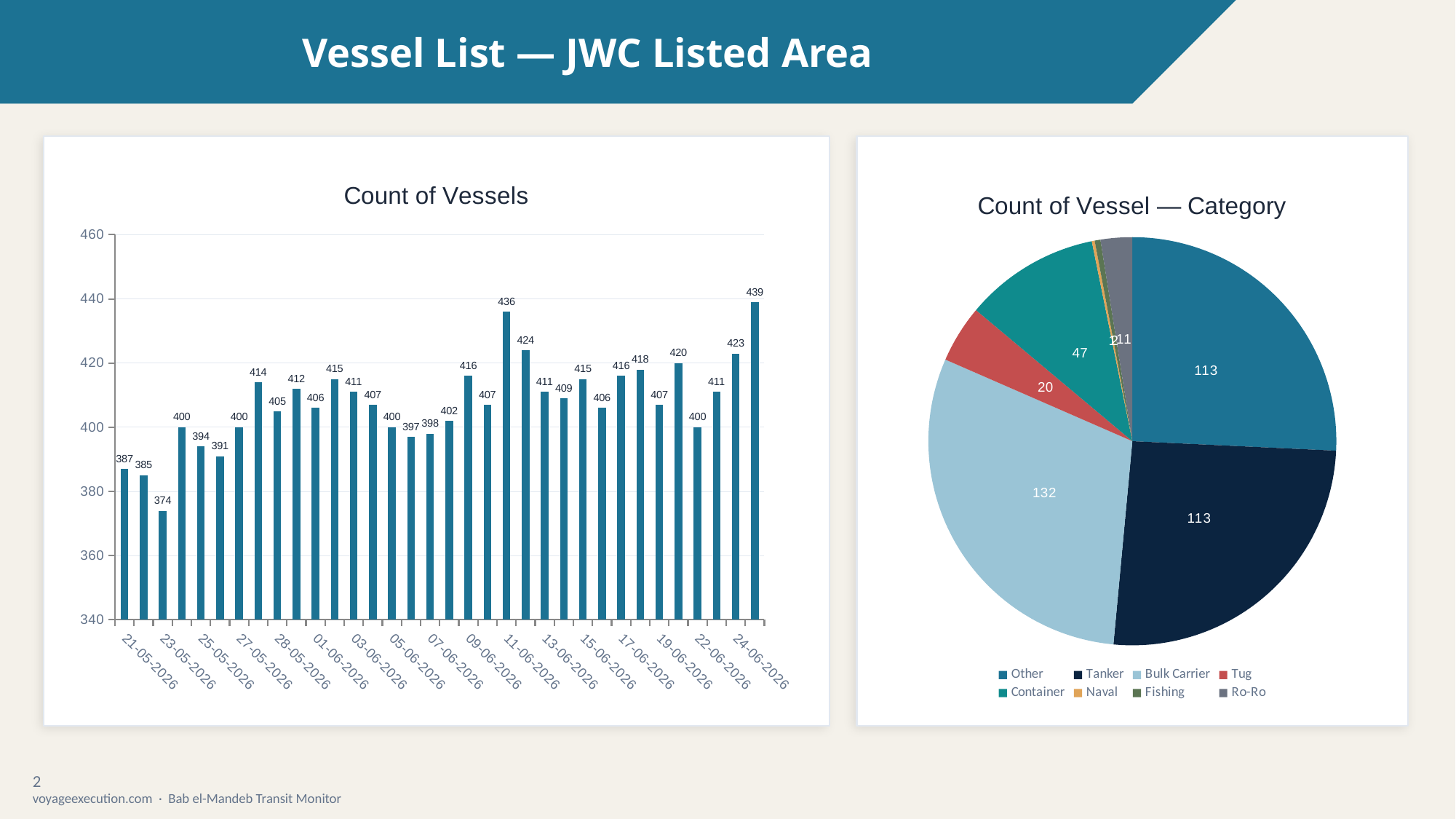
In the 'Count of Vessels' chart, is the value for 21-05-2026 greater or less than 400? less In the 'Count of Vessel — Category' pie chart, what is the value for Container? 47 In the 'Count of Vessels' chart, what is the lowest value shown? 374 How many categories does the legend of the 'Count of Vessel — Category' pie chart list? 8 In the 'Count of Vessels' chart, what is the value for 21-05-2026? 387 In the 'Count of Vessel — Category' pie chart, what is the difference between Bulk Carrier and Tanker? 19 What kind of chart is the 'Count of Vessel — Category' chart on the right? pie chart In the 'Count of Vessel — Category' pie chart, which category has the largest slice? Bulk Carrier What kind of chart is the 'Count of Vessels' chart on the left? bar chart In the 'Count of Vessel — Category' pie chart, which is larger, Container or Tug? Container In the 'Count of Vessel — Category' pie chart, what is the value for Bulk Carrier? 132 In the 'Count of Vessels' chart, what is the highest value shown? 439